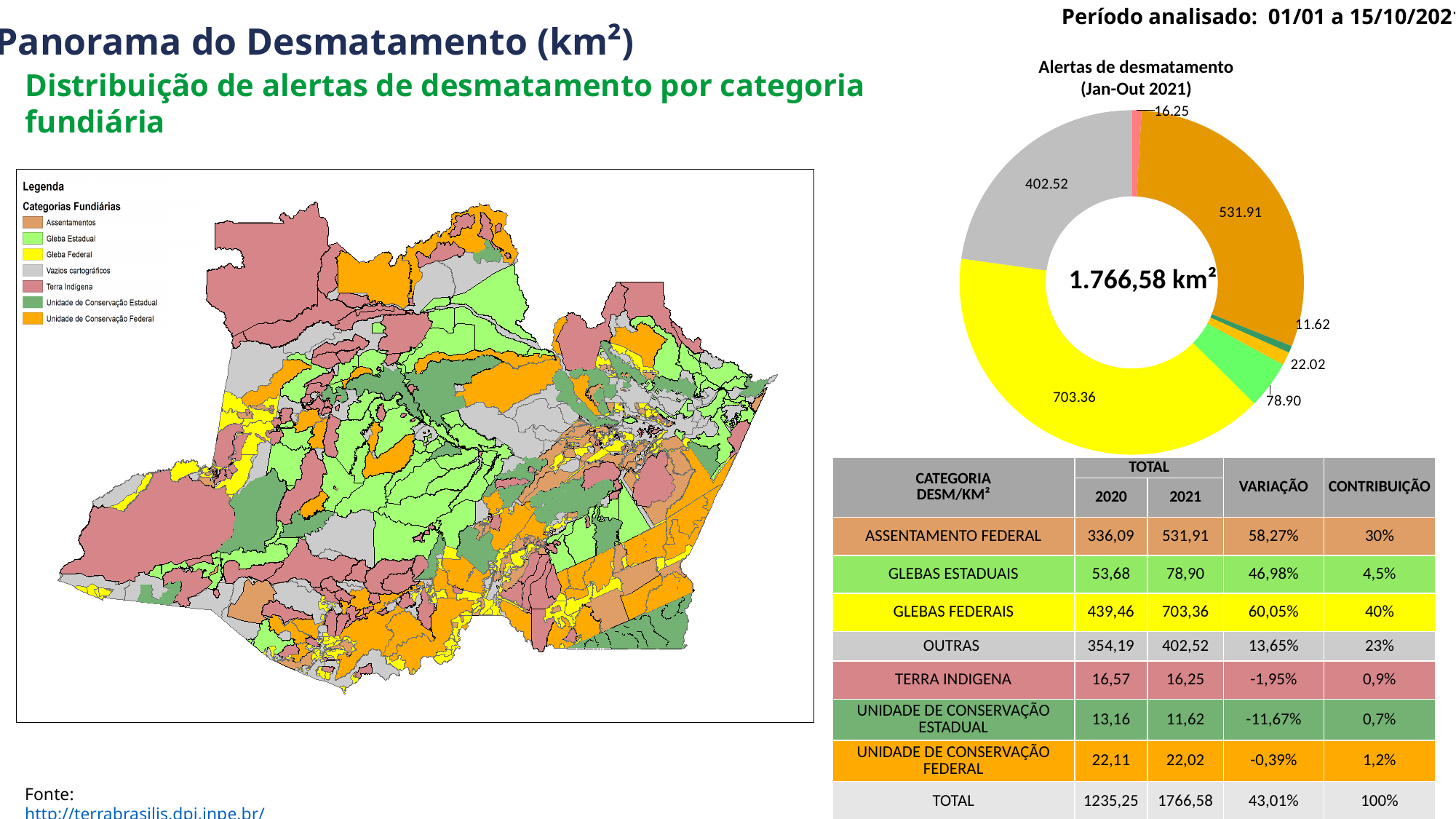
How many slices does the 'Alertas de desmatamento (Jan-Out 2021)' donut chart have? 7 In the 'Alertas de desmatamento (Jan-Out 2021)' chart, which is larger: the grey slice or the orange-brown slice? The orange-brown slice (531.91) What is the title of the donut chart on the slide? Alertas de desmatamento (Jan-Out 2021) In the 'Alertas de desmatamento (Jan-Out 2021)' chart, what value is shown for the light green slice? 78.90 What kind of chart is 'Alertas de desmatamento (Jan-Out 2021)'? Pie (donut) chart What is the value of the largest slice in the 'Alertas de desmatamento (Jan-Out 2021)' chart? 703.36 In the 'Alertas de desmatamento (Jan-Out 2021)' chart, what is the difference between the yellow slice (703.36) and the orange-brown slice (531.91)? 171.45 What total is printed in the centre of the 'Alertas de desmatamento (Jan-Out 2021)' donut chart? 1.766,58 km² In the 'Alertas de desmatamento (Jan-Out 2021)' chart, what value is shown for the grey slice? 402.52 What is the value of the smallest slice in the 'Alertas de desmatamento (Jan-Out 2021)' chart? 11.62 In the 'Alertas de desmatamento (Jan-Out 2021)' chart, what value is shown for the pink slice? 16.25 In the 'Alertas de desmatamento (Jan-Out 2021)' chart, which is larger: the slice labelled 22.02 or the slice labelled 11.62? 22.02